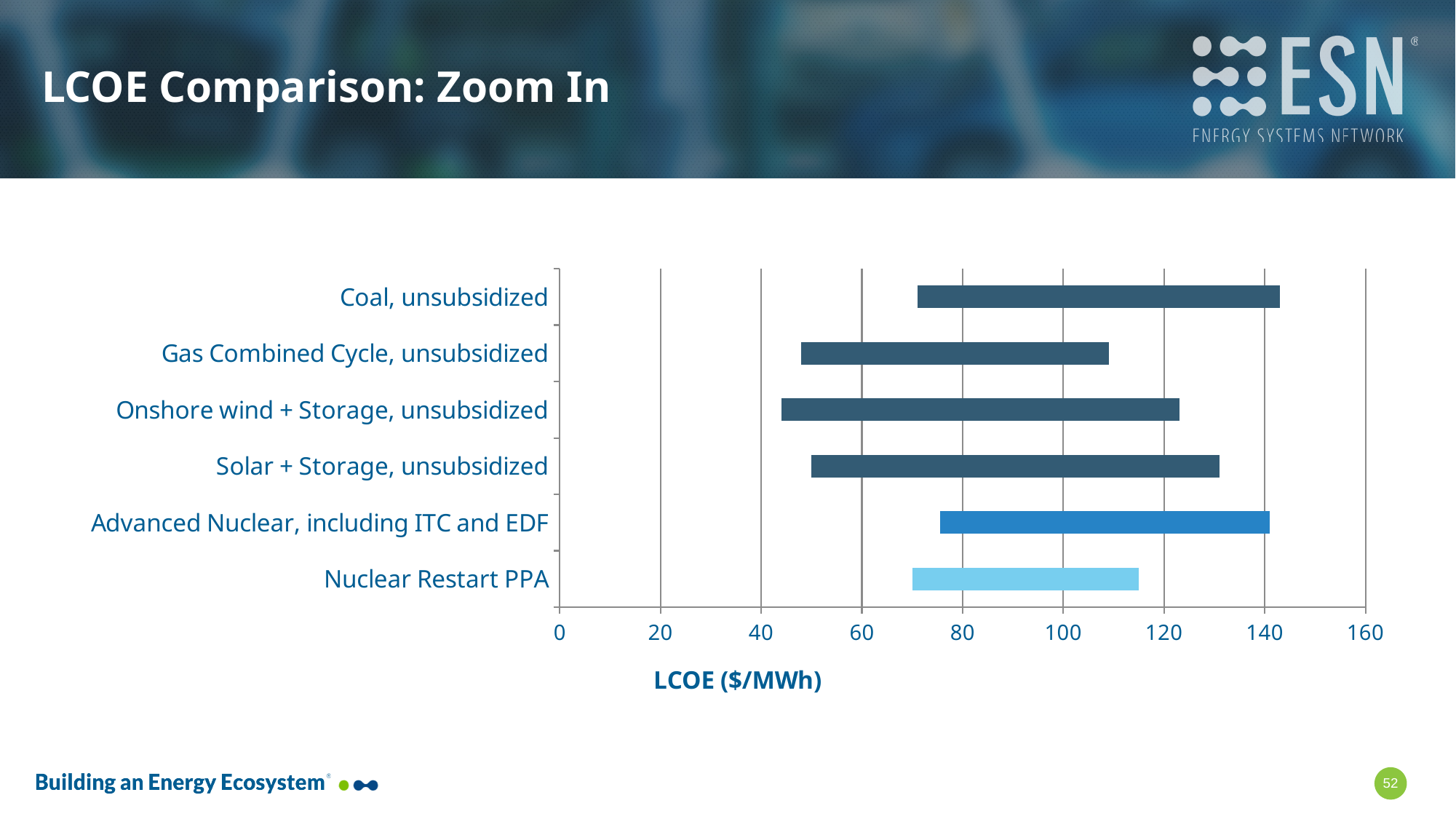
Is the upper end of the bar for Gas Combined Cycle, unsubsidized greater or less than 120? less Is the lower end of the bar for Advanced Nuclear, including ITC and EDF greater or less than 60? greater Is the lower end of the bar for Onshore wind + Storage, unsubsidized greater or less than 60? less Which bar extends further to the right: Solar + Storage, unsubsidized or Nuclear Restart PPA? Solar + Storage, unsubsidized Which bar extends further to the right: Coal, unsubsidized or Gas Combined Cycle, unsubsidized? Coal, unsubsidized Which bar starts further to the left: Onshore wind + Storage, unsubsidized or Advanced Nuclear, including ITC and EDF? Onshore wind + Storage, unsubsidized What is the title of the chart slide? LCOE Comparison: Zoom In How many categories are plotted on the chart? 6 What is the label of the horizontal axis? LCOE ($/MWh) What kind of chart is shown on the slide? bar chart